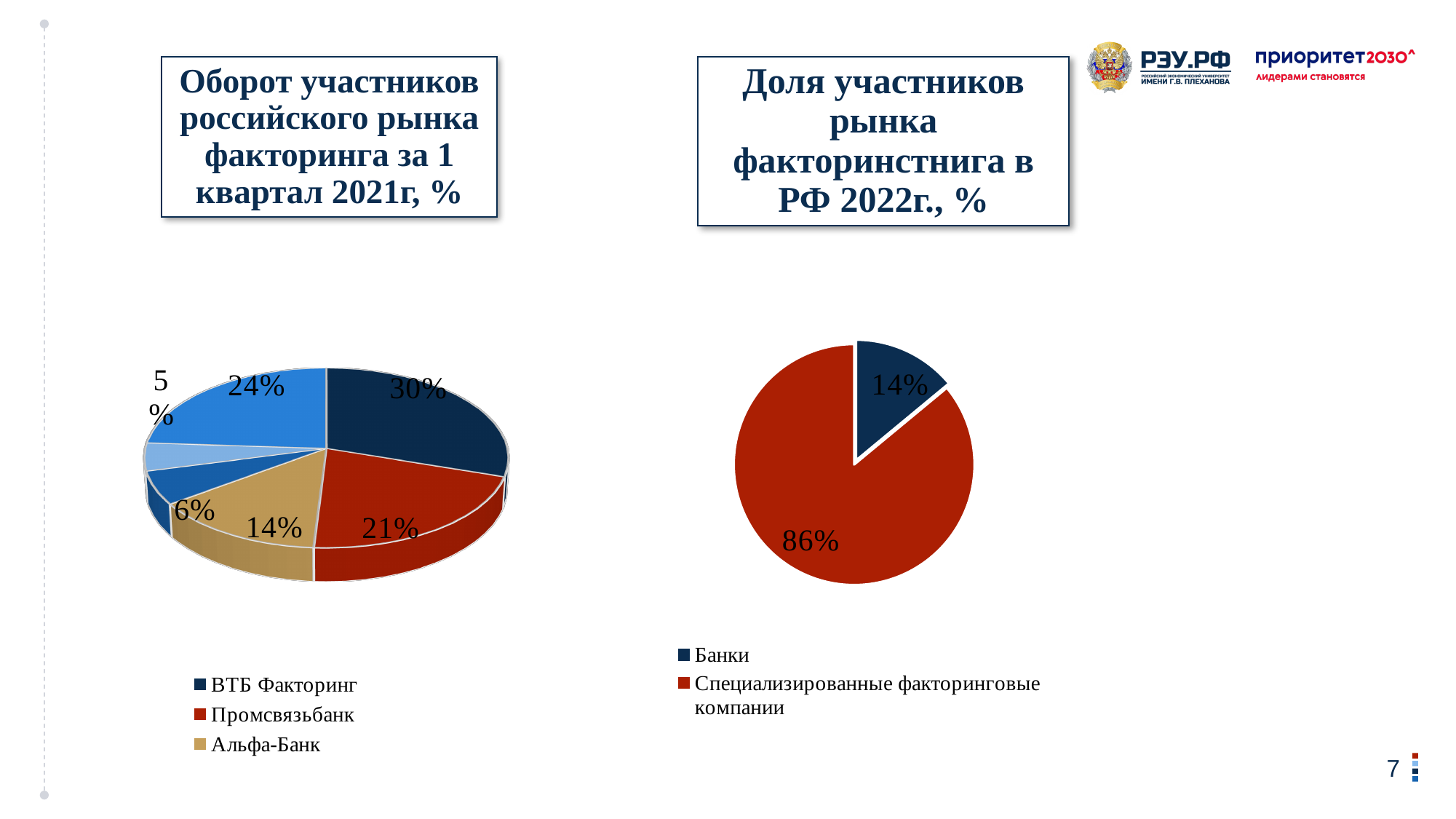
In the right pie chart (Доля участников рынка факторинга в РФ 2022г.), what share is shown for Банки? 14% In the left pie chart, which is larger: the share of ВТБ Факторинг or the share of Промсвязьбанк? ВТБ Факторинг In the right pie chart, which category has the largest share? Специализированные факторинговые компании How many entries does the legend of the left chart list? 3 What type of chart is used on the right side of the slide? Pie chart How many slices does the left pie chart have? 6 In the left pie chart, what share is shown for Промсвязьбанк? 21% In the right pie chart, what share is shown for Специализированные факторинговые компании? 86% In the left pie chart, which of the three legend entries has the largest share? ВТБ Факторинг In the left pie chart, what share is shown for Альфа-Банк? 14% In the left pie chart (Оборот участников российского рынка факторинга за 1 квартал 2021г), what share is shown for ВТБ Факторинг? 30% In the right pie chart, what is the difference in percentage points between Специализированные факторинговые компании and Банки? 72